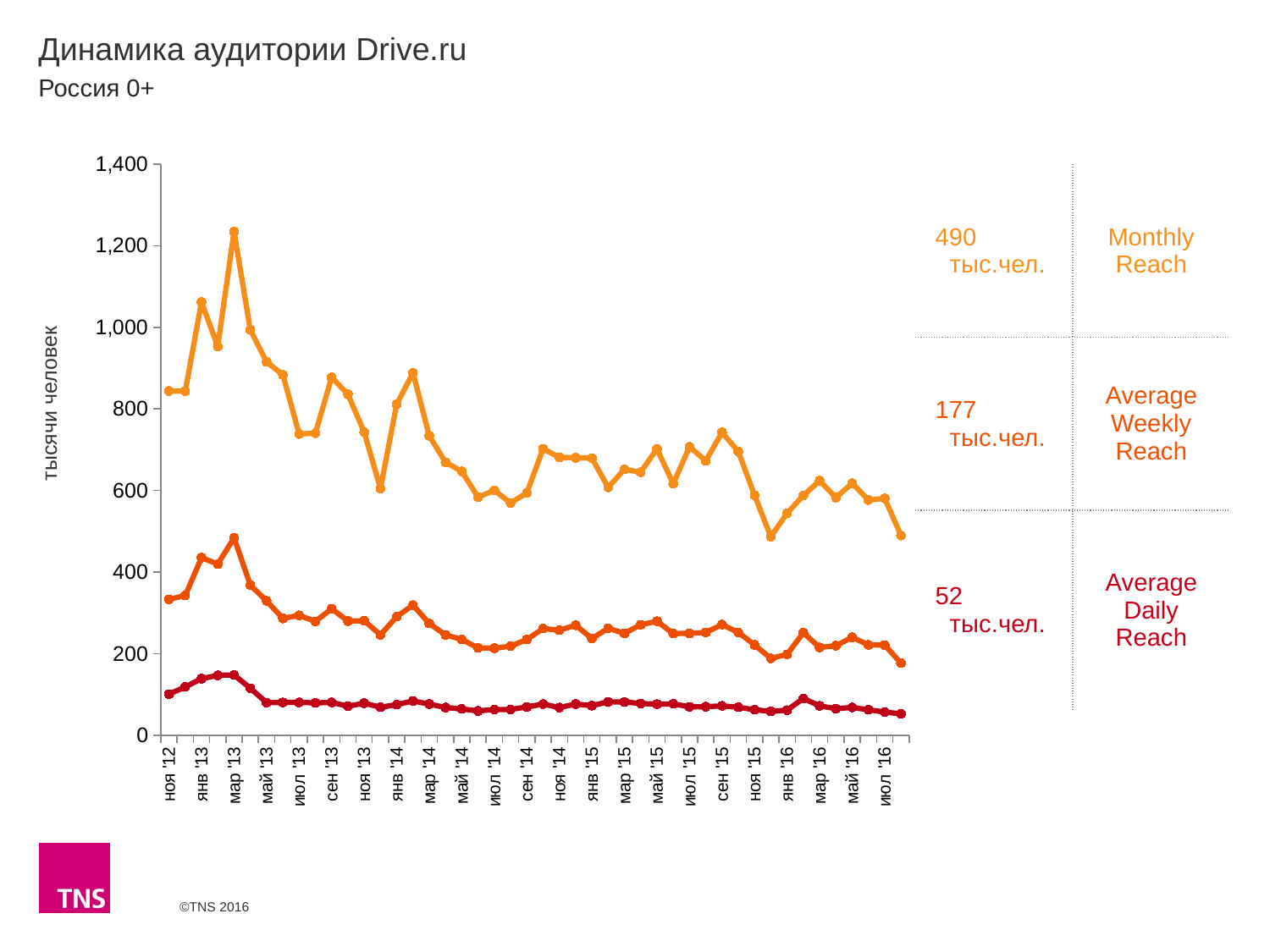
What is the latest Monthly Reach value shown on the slide? 490 тыс.чел. How many series are plotted on the chart? 3 Is the Average Daily Reach value for ноя '12 greater or less than 200? less Does the Monthly Reach line rise or fall overall from ноя '12 to the end of the chart? fall What is the latest Average Weekly Reach value shown on the slide? 177 тыс.чел. Is the Monthly Reach value for мар '13 greater or less than 1,200? greater What is the label on the vertical axis of the chart? тысячи человек What is the latest Average Daily Reach value shown on the slide? 52 тыс.чел. What is the difference between the latest Monthly Reach and the latest Average Weekly Reach values? 313 тыс.чел. What kind of chart is shown on the slide? line chart Which series has the lowest values throughout the chart? Average Daily Reach Which series has the highest values throughout the chart? Monthly Reach